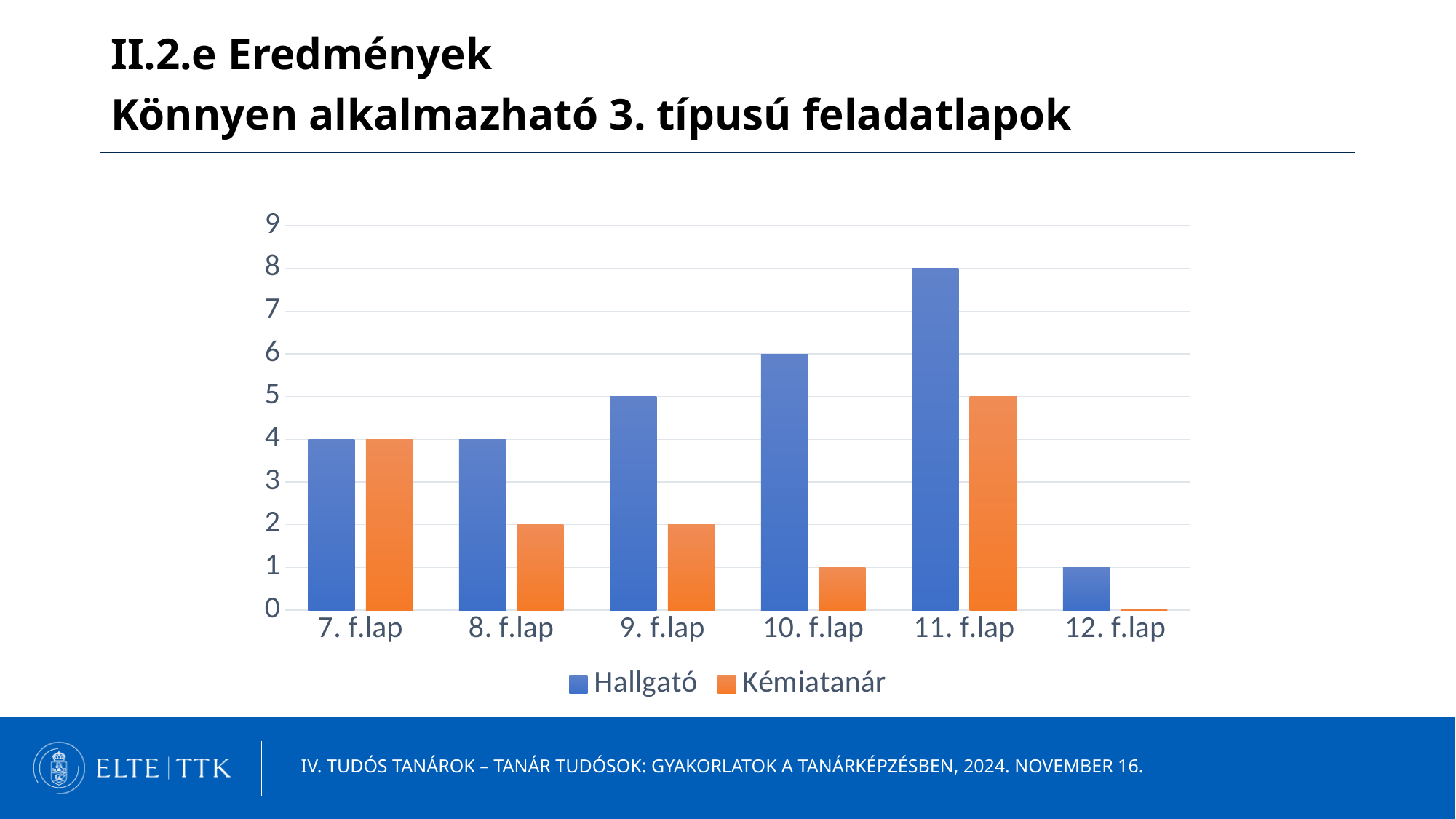
Which category has the lowest Kémiatanár value? 12. f.lap Which is larger for 8. f.lap, the Hallgató value or the Kémiatanár value? Hallgató How many series does the legend list? 2 What is the difference between the Hallgató and Kémiatanár values for 10. f.lap? 5 Which series is shown in orange in the legend? Kémiatanár What kind of chart is shown on the slide? bar chart Is the Hallgató value for 10. f.lap greater or less than 5? greater Which category has the highest Hallgató value? 11. f.lap What is the Hallgató value for 9. f.lap? 5 How many categories are shown on the x axis? 6 What is the Kémiatanár value for 10. f.lap? 1 What is the Hallgató value for 11. f.lap? 8